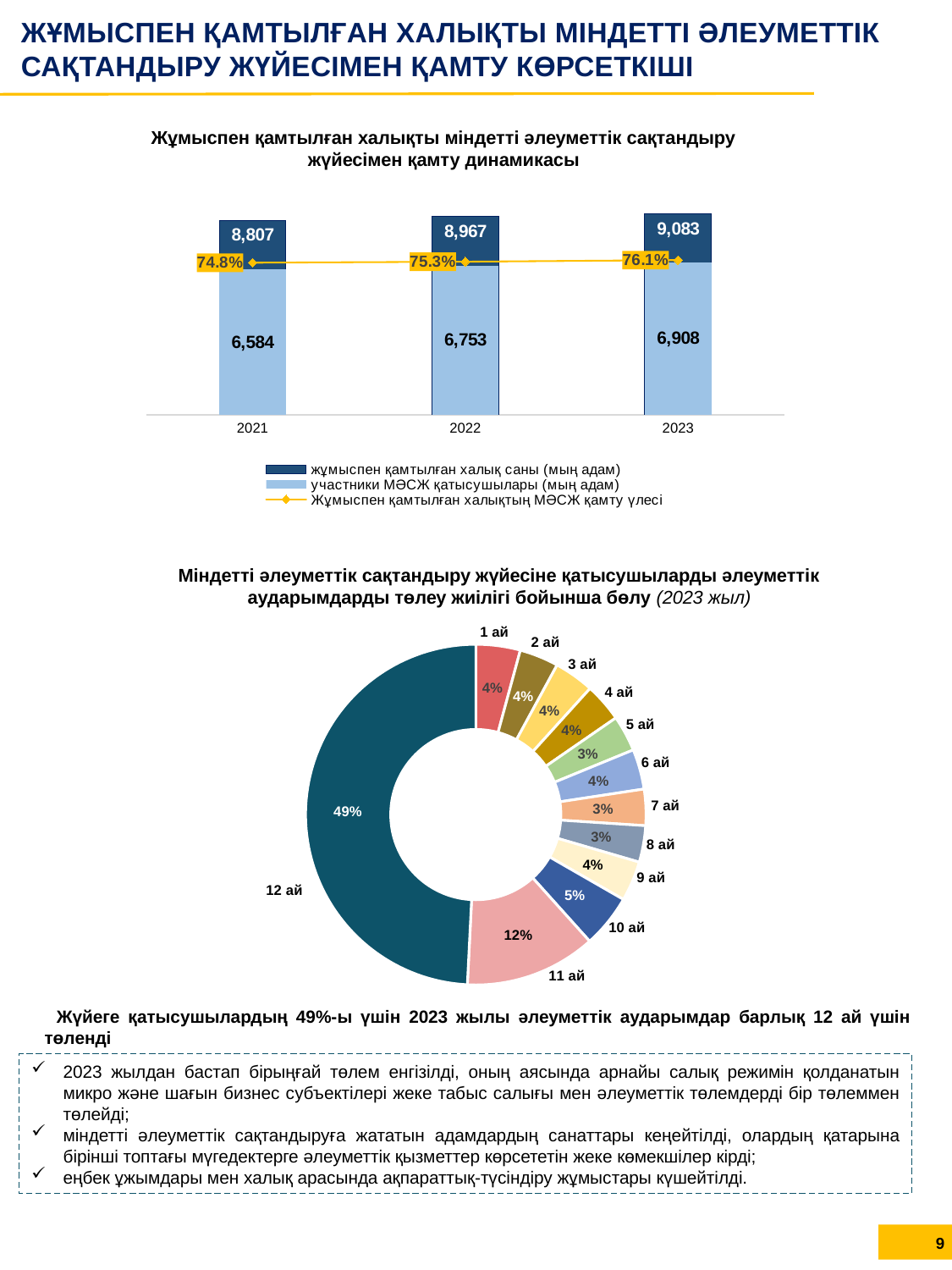
In the bottom donut chart, which category has the largest share? 12 ай In the bottom donut chart, which is larger: the share for 10 ай or the share for 5 ай? 10 ай In the top bar chart, what coverage share (Жұмыспен қамтылған халықтың МӘСЖ қамту үлесі) is shown for 2022? 75.3% In the top bar chart, what is the difference between the dark blue series values for 2023 and 2021? 276 In the bottom donut chart, what share is shown for 11 ай? 12% In the top bar chart, does the coverage share line rise or fall from 2021 to 2023? rise How many years are shown on the x axis of the top bar chart? 3 In the top bar chart, what is the value of the light blue series (участники МӘСЖ қатысушылары) for 2021? 6,584 What type of chart is the bottom chart on the slide? Donut (pie) chart How many series does the legend of the top chart list? 3 In the top bar chart, which year has the highest value for the light blue series (участники МӘСЖ қатысушылары)? 2023 In the top bar chart, what is the value of the dark blue series (жұмыспен қамтылған халық саны) for 2023? 9,083